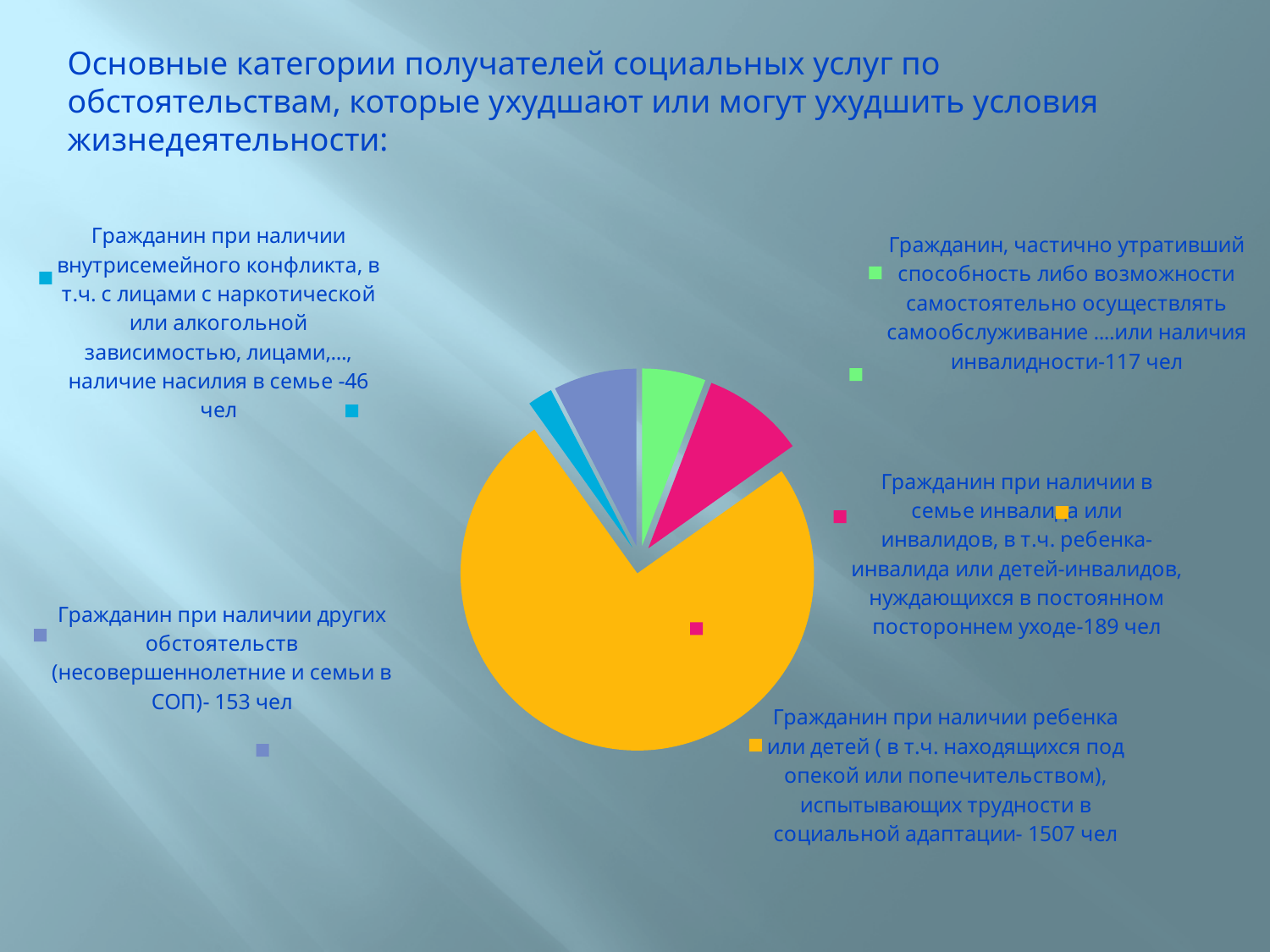
What kind of chart is shown on the slide? pie chart Which category has the smallest number of people? Гражданин при наличии внутрисемейного конфликта ... наличие насилия в семье How many people are in the category 'Гражданин, частично утративший способность либо возможности самостоятельно осуществлять самообслуживание ... или наличия инвалидности'? 117 чел How many people are in the category 'Гражданин при наличии внутрисемейного конфликта ... наличие насилия в семье'? 46 чел What colour is the largest slice of the pie chart? yellow How many categories (slices) does the pie chart have? 5 How many people are in the category 'Гражданин при наличии других обстоятельств (несовершеннолетние и семьи в СОП)'? 153 чел How many people are in the category 'Гражданин при наличии ребенка или детей ... испытывающих трудности в социальной адаптации'? 1507 чел Which category has the largest number of people? Гражданин при наличии ребенка или детей (в т.ч. находящихся под опекой или попечительством), испытывающих трудности в социальной адаптации Which category has more people: 'Гражданин при наличии других обстоятельств (несовершеннолетние и семьи в СОП)' or 'Гражданин, частично утративший способность ... или наличия инвалидности'? Гражданин при наличии других обстоятельств (несовершеннолетние и семьи в СОП) What is the difference between the number of people in the category with a disabled family member (189 чел) and the category of citizens who partially lost the ability to self-care (117 чел)? 72 чел How many people are in the category 'Гражданин при наличии в семье инвалида или инвалидов ... нуждающихся в постоянном постороннем уходе'? 189 чел